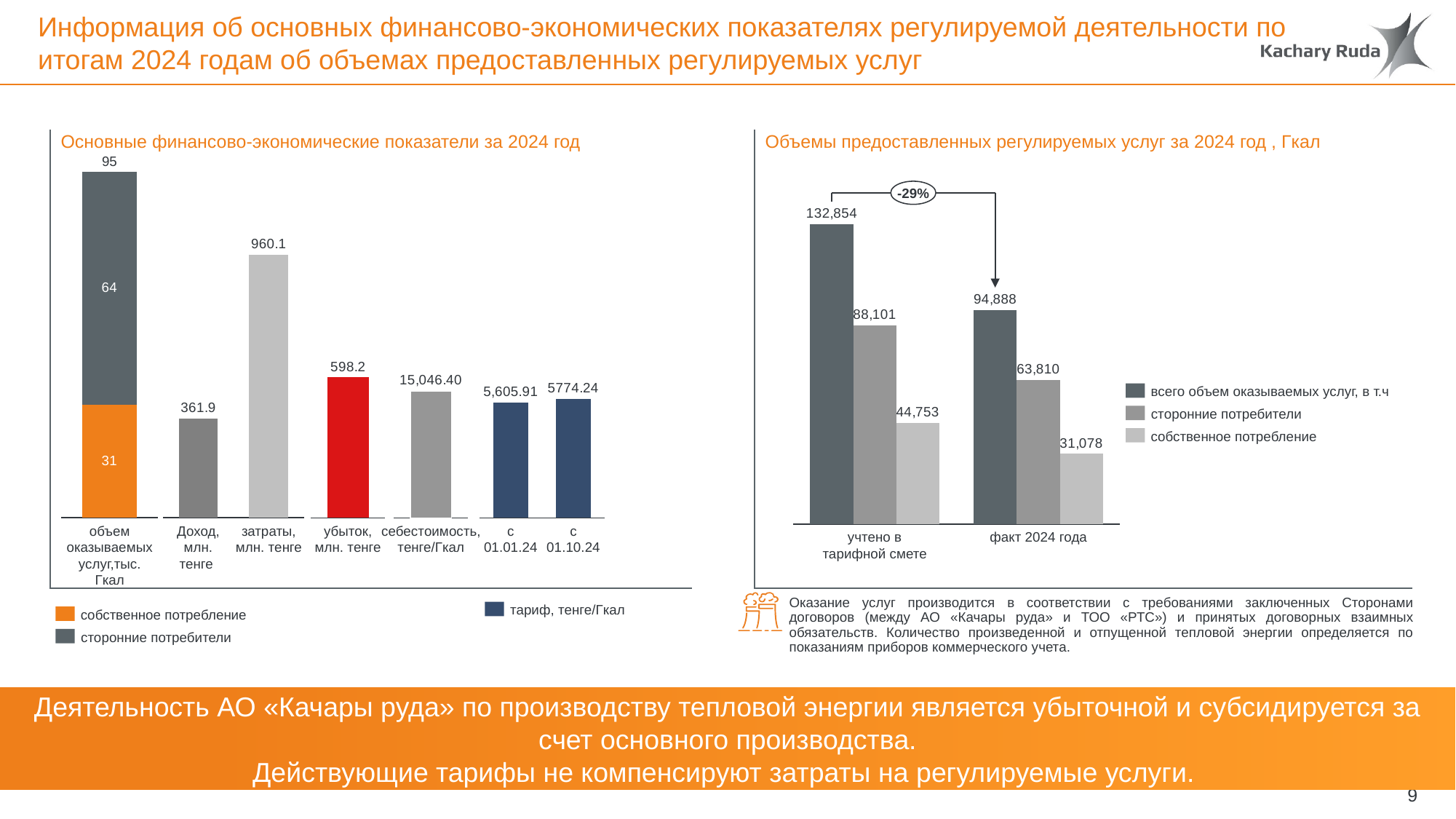
In the chart 'Объемы предоставленных регулируемых услуг за 2024 год, Гкал', what is the value of 'собственное потребление' for 'факт 2024 года'? 31,078 What type of chart is 'Объемы предоставленных регулируемых услуг за 2024 год, Гкал'? bar chart In the chart 'Объемы предоставленных регулируемых услуг за 2024 год, Гкал', how many series does the legend list? 3 In the chart 'Объемы предоставленных регулируемых услуг за 2024 год, Гкал', what percentage change is shown between 'учтено в тарифной смете' and 'факт 2024 года'? -29% In the chart 'Основные финансово-экономические показатели за 2024 год', what is the difference between 'затраты, млн. тенге' and 'Доход, млн. тенге'? 598.2 In the chart 'Объемы предоставленных регулируемых услуг за 2024 год, Гкал', what is the difference between 'сторонние потребители' for 'учтено в тарифной смете' and for 'факт 2024 года'? 24,291 In the chart 'Основные финансово-экономические показатели за 2024 год', what is the value for 'затраты, млн. тенге'? 960.1 In the chart 'Основные финансово-экономические показатели за 2024 год', what is the value for 'убыток, млн. тенге'? 598.2 In the chart 'Объемы предоставленных регулируемых услуг за 2024 год, Гкал', what is the value of 'всего объем оказываемых услуг' for 'учтено в тарифной смете'? 132,854 In the chart 'Основные финансово-экономические показатели за 2024 год', which is larger: the tariff 'с 01.01.24' or 'с 01.10.24'? с 01.10.24 In the chart 'Основные финансово-экономические показатели за 2024 год', what is the total of the stacked bar 'объем оказываемых услуг, тыс. Гкал'? 95 In the chart 'Основные финансово-экономические показатели за 2024 год', what is the 'собственное потребление' portion of the stacked bar 'объем оказываемых услуг, тыс. Гкал'? 31